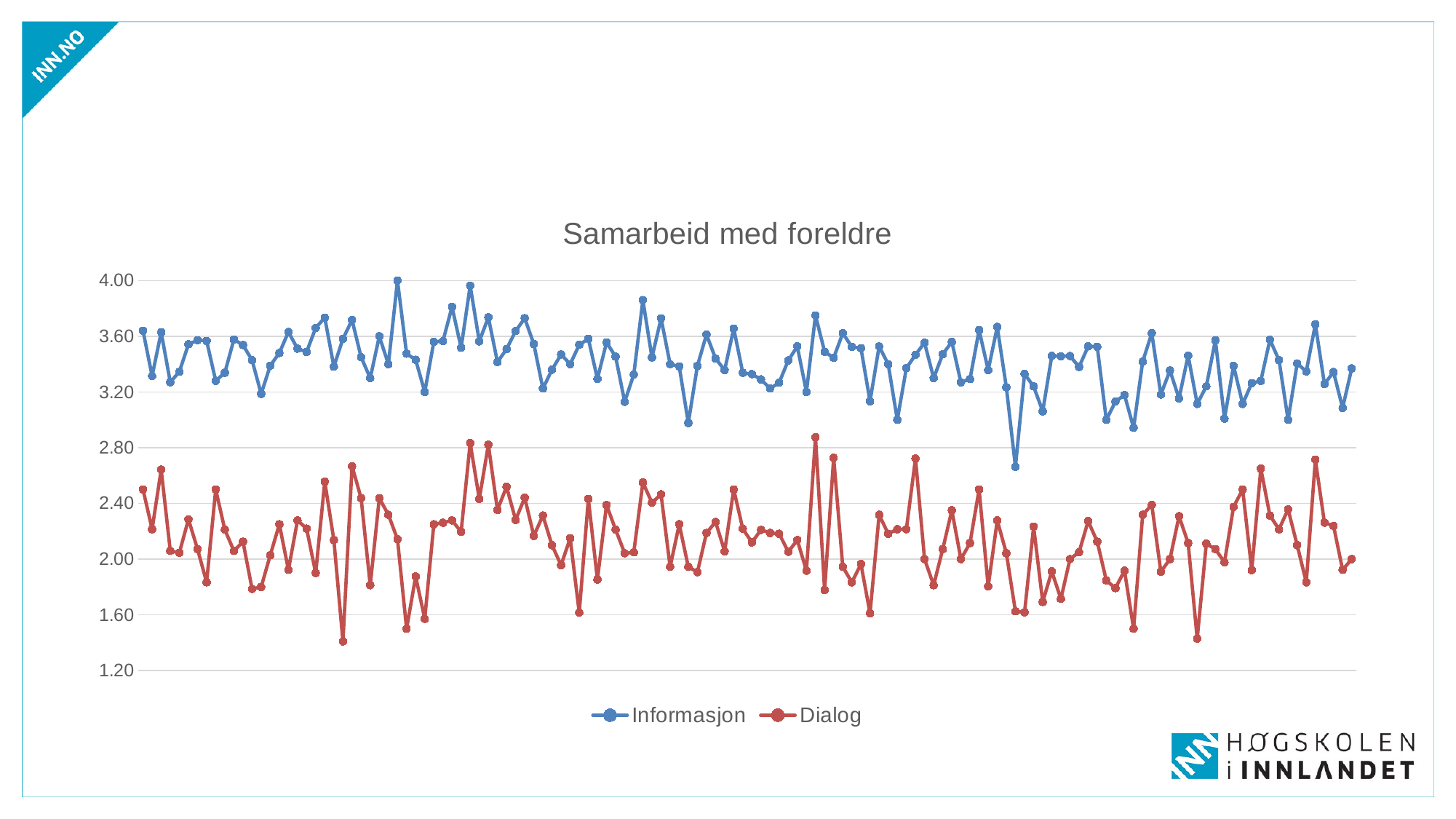
Is the lowest value of the Informasjon series greater or less than 2.40? greater Is the highest value of the Dialog series greater or less than 3.20? less Is the lowest value of the Dialog series greater or less than 1.60? less What is the title of the chart? Samarbeid med foreldre What is the lowest value shown on the vertical axis? 1.20 How many series does the legend list? 2 What kind of chart is shown on the slide? line chart Which series has the higher values throughout the chart, Informasjon or Dialog? Informasjon What are the names of the two series in the legend? Informasjon and Dialog